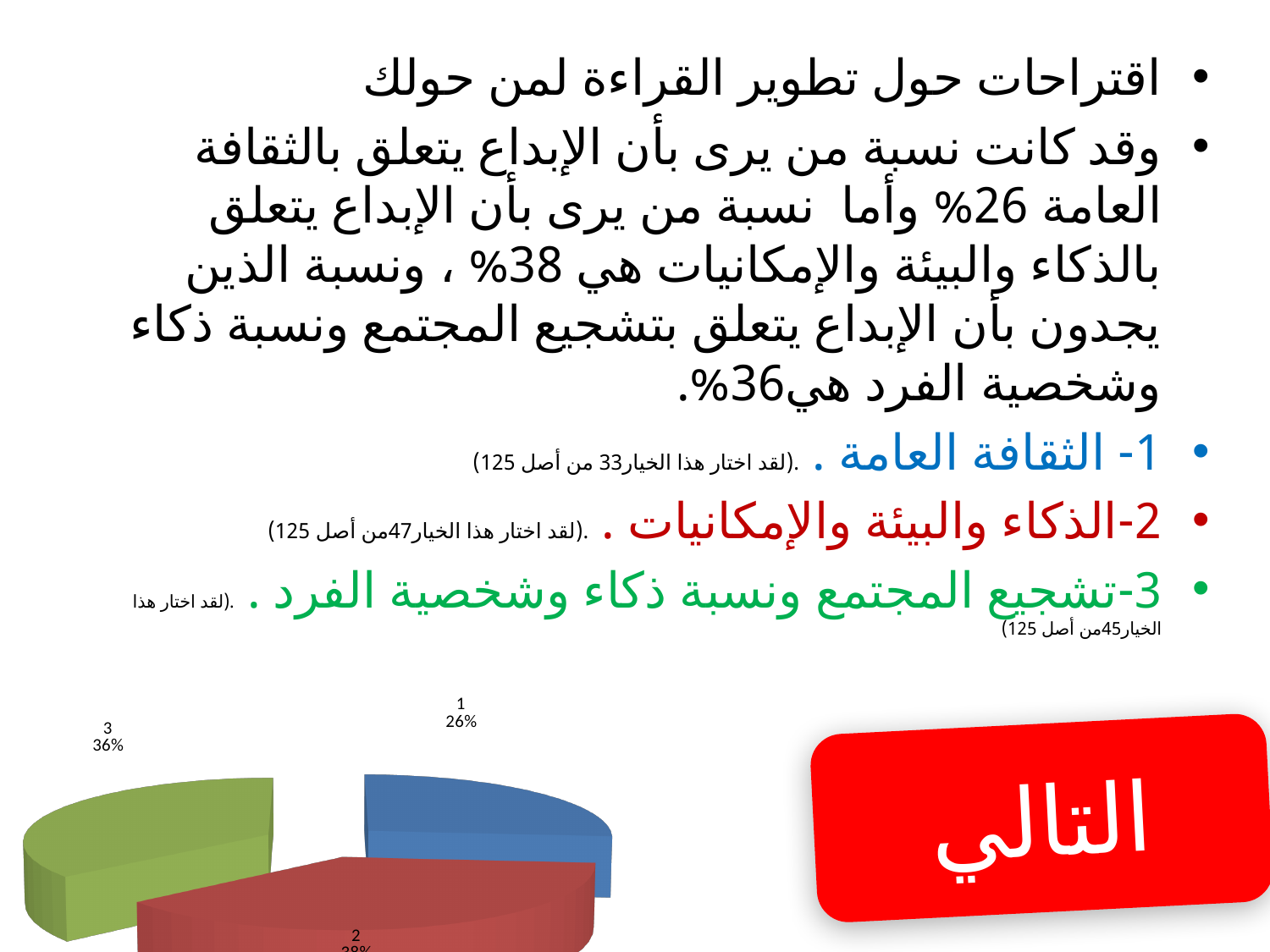
How many slices does the pie chart have? 3 What colour is slice 1 in the pie chart? blue What percentage is shown for slice 3 in the pie chart? 36% What type of chart is shown at the bottom of the slide? pie chart Which is larger in the pie chart, slice 1 or slice 3? 3 What is the difference between the percentages of slice 3 and slice 1 in the pie chart? 10% What colour is slice 3 in the pie chart? green Which slice of the pie chart is the smallest? 1 What percentage is shown for slice 1 in the pie chart? 26%